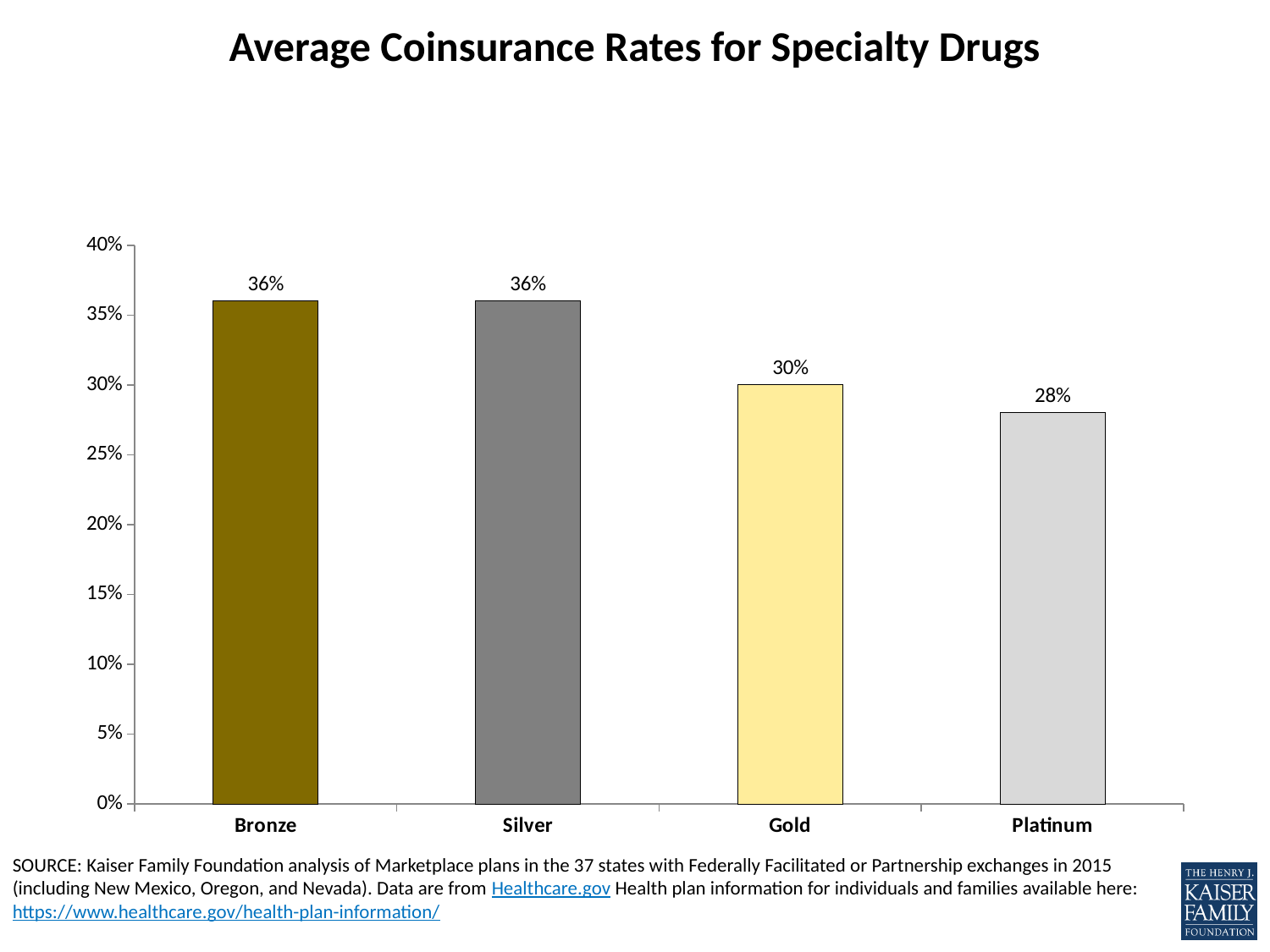
What is the title of the chart? Average Coinsurance Rates for Specialty Drugs What is the difference between the Silver and Platinum average coinsurance rates? 8% What is the average coinsurance rate for specialty drugs for Platinum plans? 28% How many plan types are shown on the chart? 4 Which plan type has the lowest average coinsurance rate for specialty drugs? Platinum What is the difference between the Gold and Platinum average coinsurance rates? 2% Which is larger, the average coinsurance rate for Gold or for Platinum? Gold What kind of chart is shown on the slide? Bar chart What is the average coinsurance rate for specialty drugs for Bronze plans? 36% What is the average coinsurance rate for specialty drugs for Gold plans? 30% Do the values rise or fall moving from Bronze to Platinum along the x axis? Fall Is the value for Gold greater or less than 35%? less